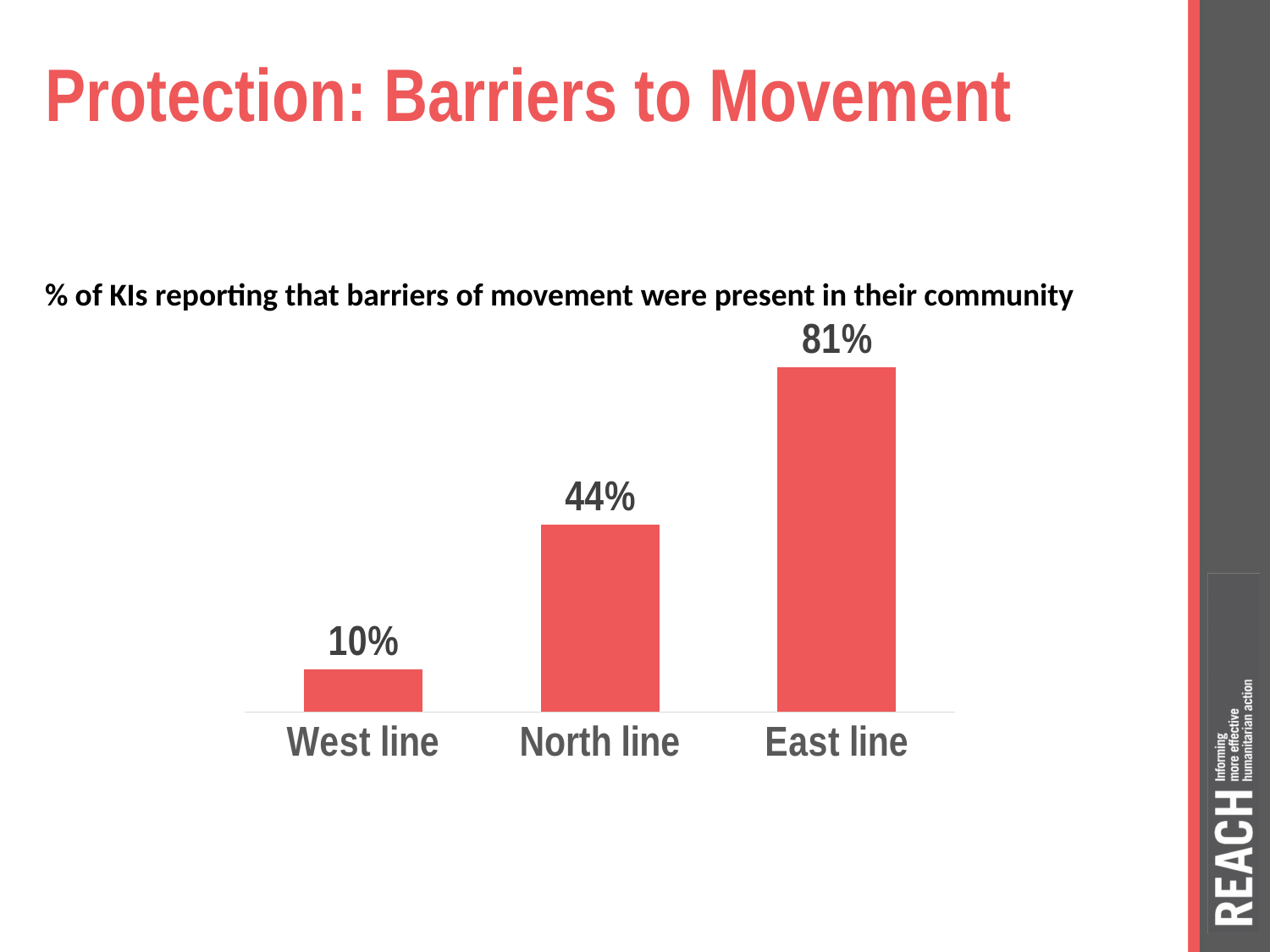
What is the value shown for East line? 81% What is the difference in percentage points between East line and West line? 71 Which line has the lowest percentage of KIs reporting barriers to movement? West line Do the values rise or fall from West line to East line? Rise Which line has the highest percentage of KIs reporting barriers to movement? East line What percentage of KIs in the West line reported that barriers of movement were present in their community? 10% How many categories are shown in the chart? 3 Which has a higher value, North line or East line? East line What is the title of the chart? % of KIs reporting that barriers of movement were present in their community What type of chart is shown on the slide? Bar chart What is the value shown for North line? 44% What is the difference in percentage points between North line and West line? 34